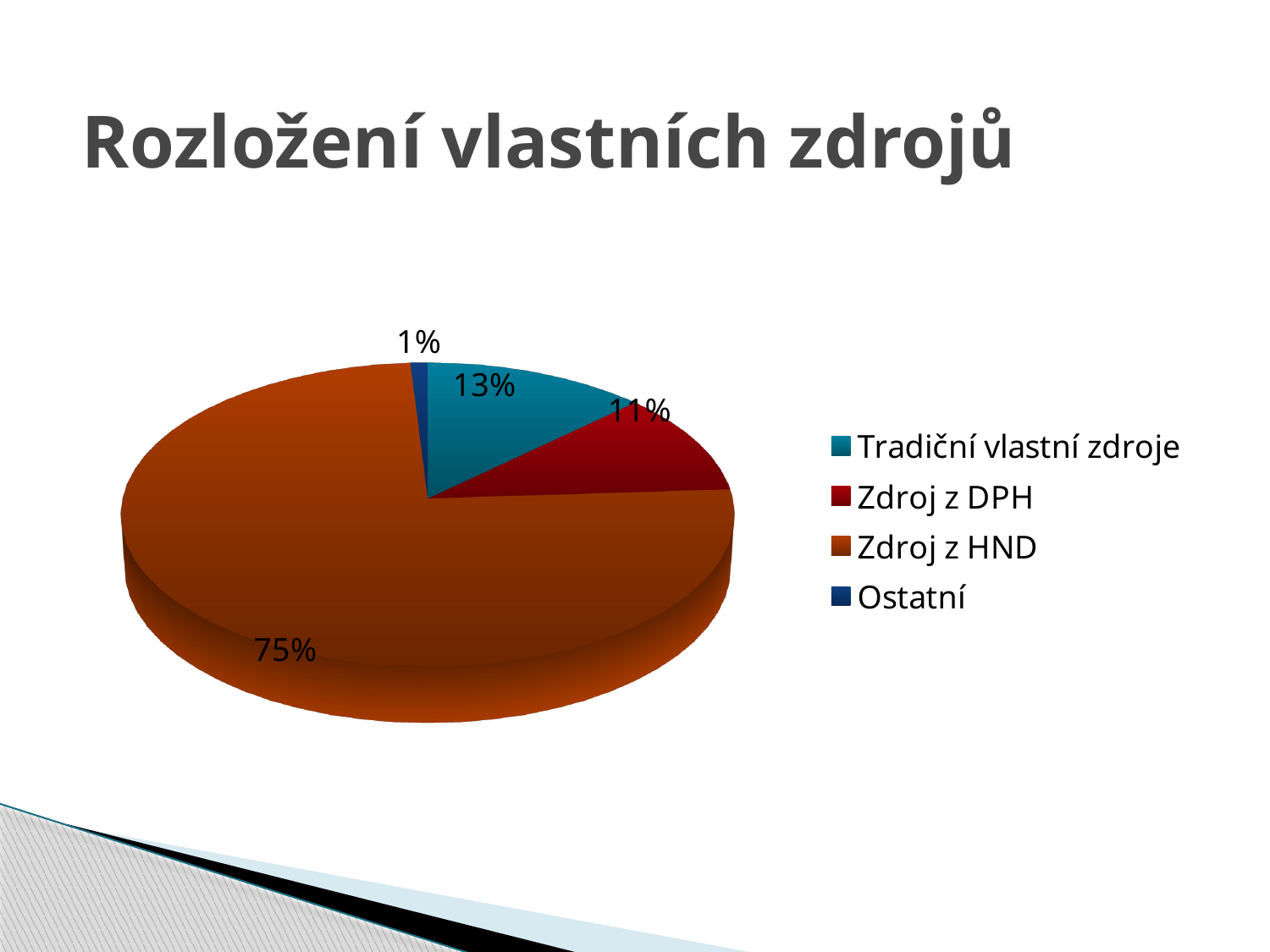
What is the difference in percentage points between Zdroj z HND and Tradiční vlastní zdroje? 62 What share of the pie does Zdroj z HND represent? 75% What is the title of the slide containing the chart? Rozložení vlastních zdrojů What share of the pie does Tradiční vlastní zdroje represent? 13% Which category has the smallest slice of the pie? Ostatní Which is larger, the slice for Tradiční vlastní zdroje or the slice for Zdroj z DPH? Tradiční vlastní zdroje How many categories are shown in the pie chart? 4 Which category has the largest slice of the pie? Zdroj z HND What share of the pie does Zdroj z DPH represent? 11% What kind of chart is shown on the slide? Pie chart Which colour represents Zdroj z DPH in the legend? Dark red